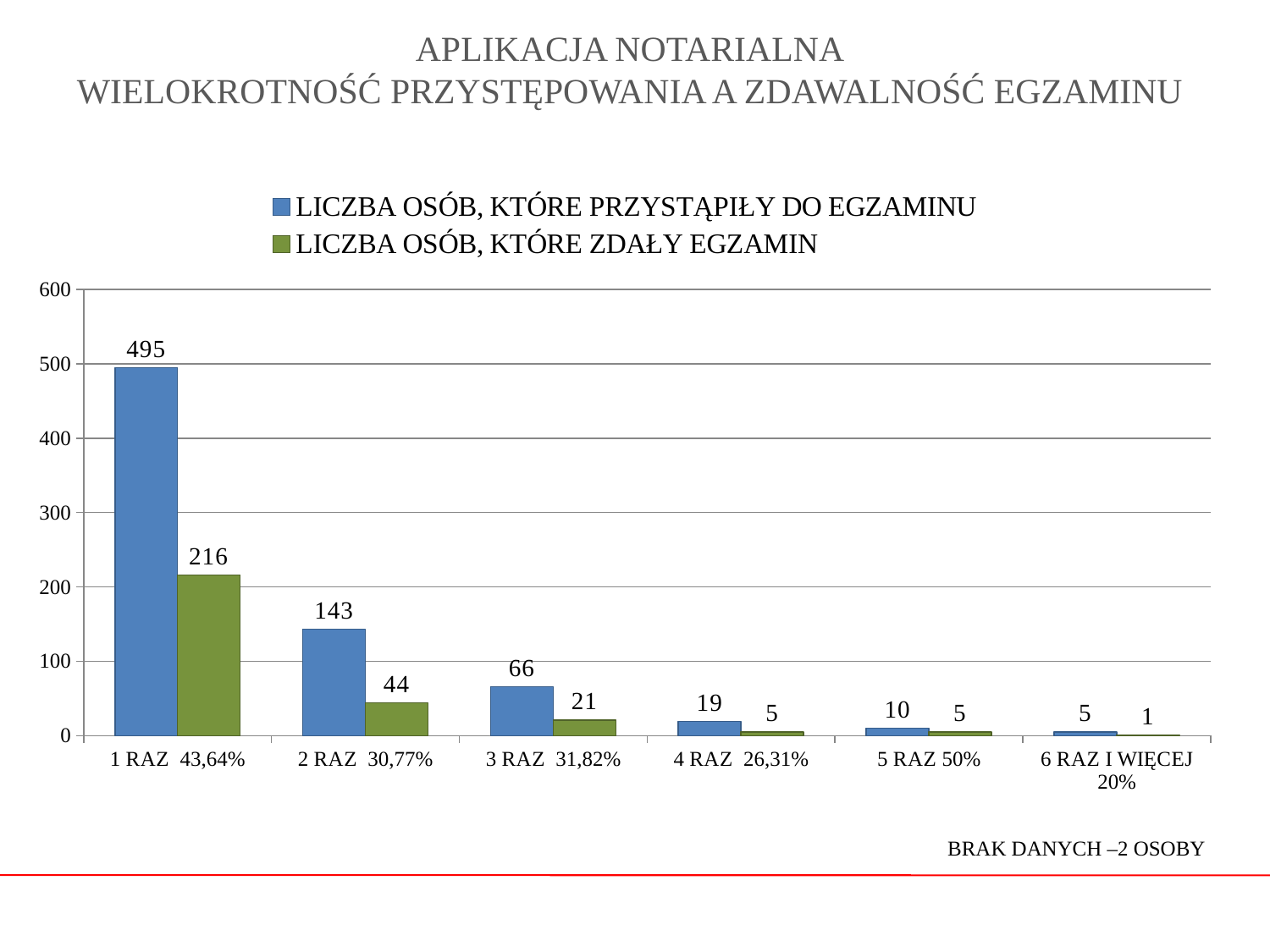
How many categories are shown on the x axis of the chart? 6 How many people passed the exam in the '2 RAZ 30,77%' category? 44 Which category has the lowest number of people who passed the exam? 6 RAZ I WIĘCEJ 20% What is the value of 'LICZBA OSÓB, KTÓRE PRZYSTĄPIŁY DO EGZAMINU' for '3 RAZ 31,82%'? 66 What type of chart is shown on the slide? Bar chart Do the values for 'LICZBA OSÓB, KTÓRE PRZYSTĄPIŁY DO EGZAMINU' rise or fall from left to right along the x axis? Fall Which is larger: the number of people who passed in '2 RAZ 30,77%' or the number who took the exam in '3 RAZ 31,82%'? 3 RAZ 31,82% (66) How many people took the exam for the first time (1 RAZ) according to the chart? 495 How many series does the legend list? 2 Which category has the highest number of people who took the exam? 1 RAZ 43,64% What is the difference between the number of people who took the exam and the number who passed in the '1 RAZ 43,64%' category? 279 What colour represents the series 'LICZBA OSÓB, KTÓRE ZDAŁY EGZAMIN' in the chart? Green